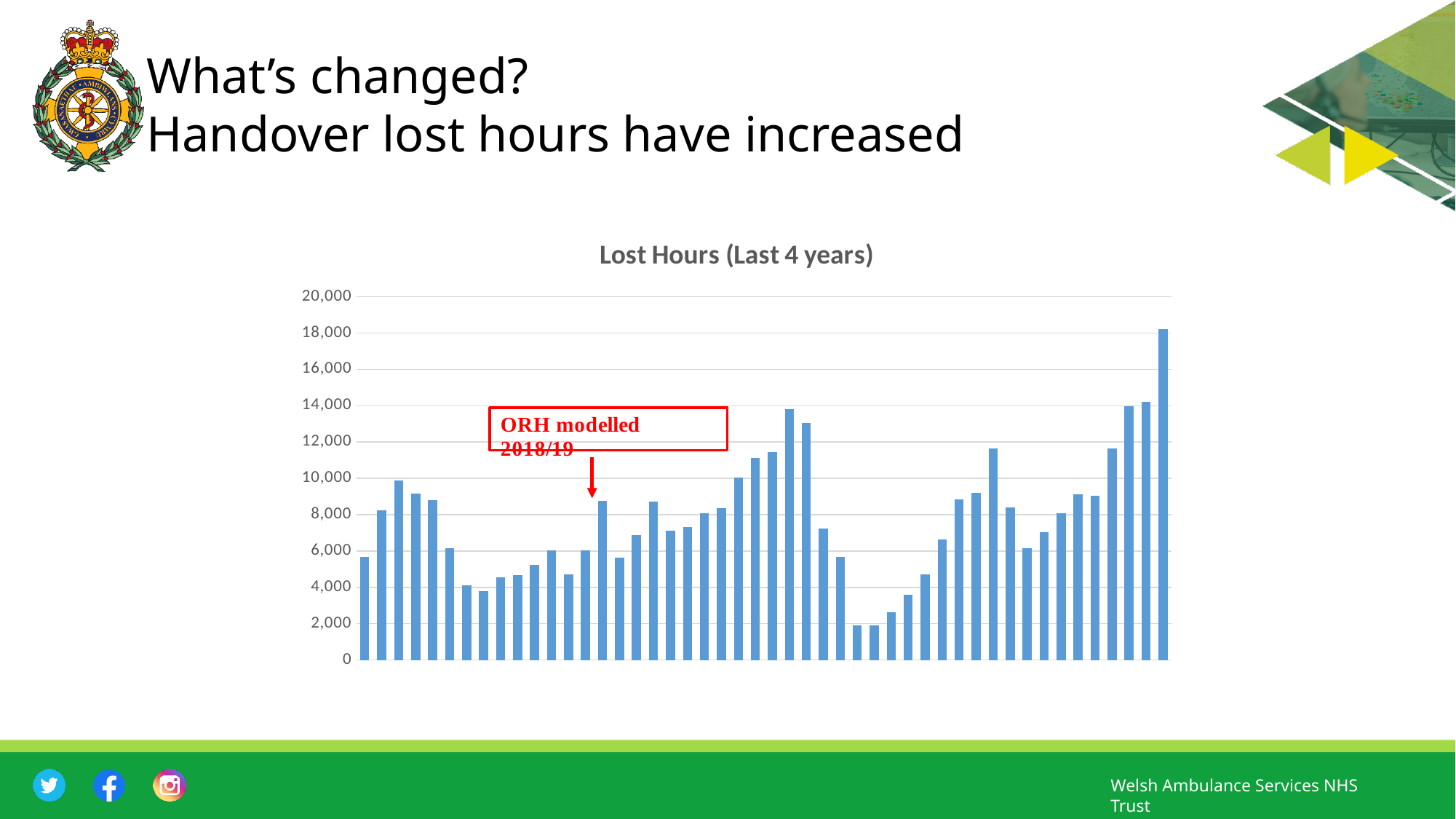
Is the value of the bar pointed to by the 'ORH modelled 2018/19' arrow greater or less than 10,000? less What is the title of the chart? Lost Hours (Last 4 years) Is the value of the tallest (rightmost) bar greater or less than 16,000? greater Is the value of the lowest bar in the chart greater or less than 4,000? less How many bars are plotted in the chart? 48 Which bar is the tallest in the chart? the last (rightmost) bar What does the red annotation on the chart say? ORH modelled 2018/19 Do the values rise or fall across the final four bars of the chart? rise What kind of chart is shown on the slide? bar chart Is the rightmost bar taller or shorter than the leftmost bar? taller